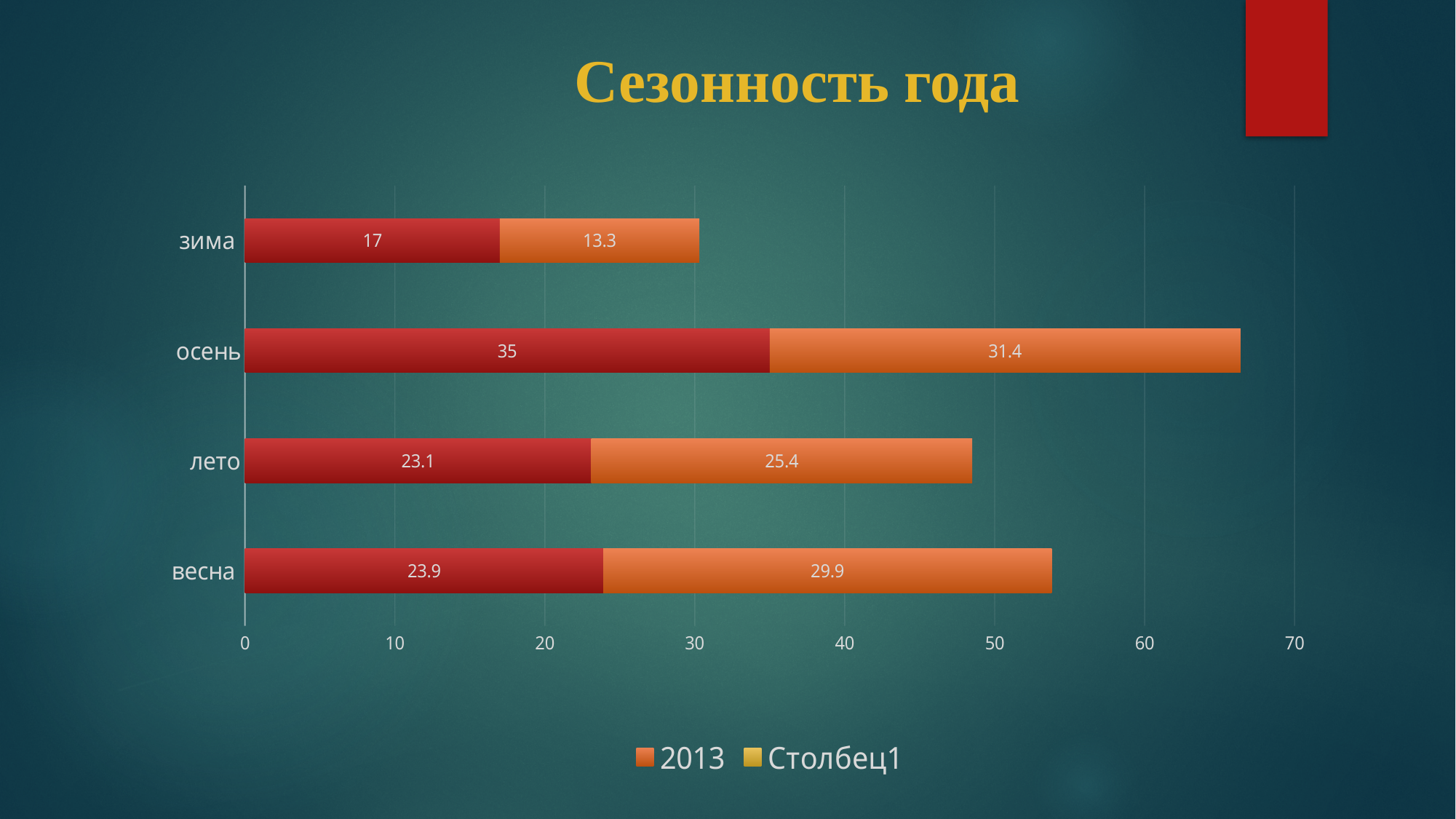
What is the value of the red (first) segment for весна? 23.9 What is the value of the red (first) segment for осень? 35 Which category has the longest total bar? осень How many series does the legend list? 2 What is the total of the stacked bar for осень? 66.4 What is the title of the chart? Сезонность года What is the difference between the orange (second) segment values for весна and лето? 4.5 Which category has the shortest total bar? зима What is the value of the orange (second) segment for зима? 13.3 What type of chart is shown on the slide? Stacked bar chart How many categories (seasons) are shown on the chart? 4 What is the total of the stacked bar for зима? 30.3